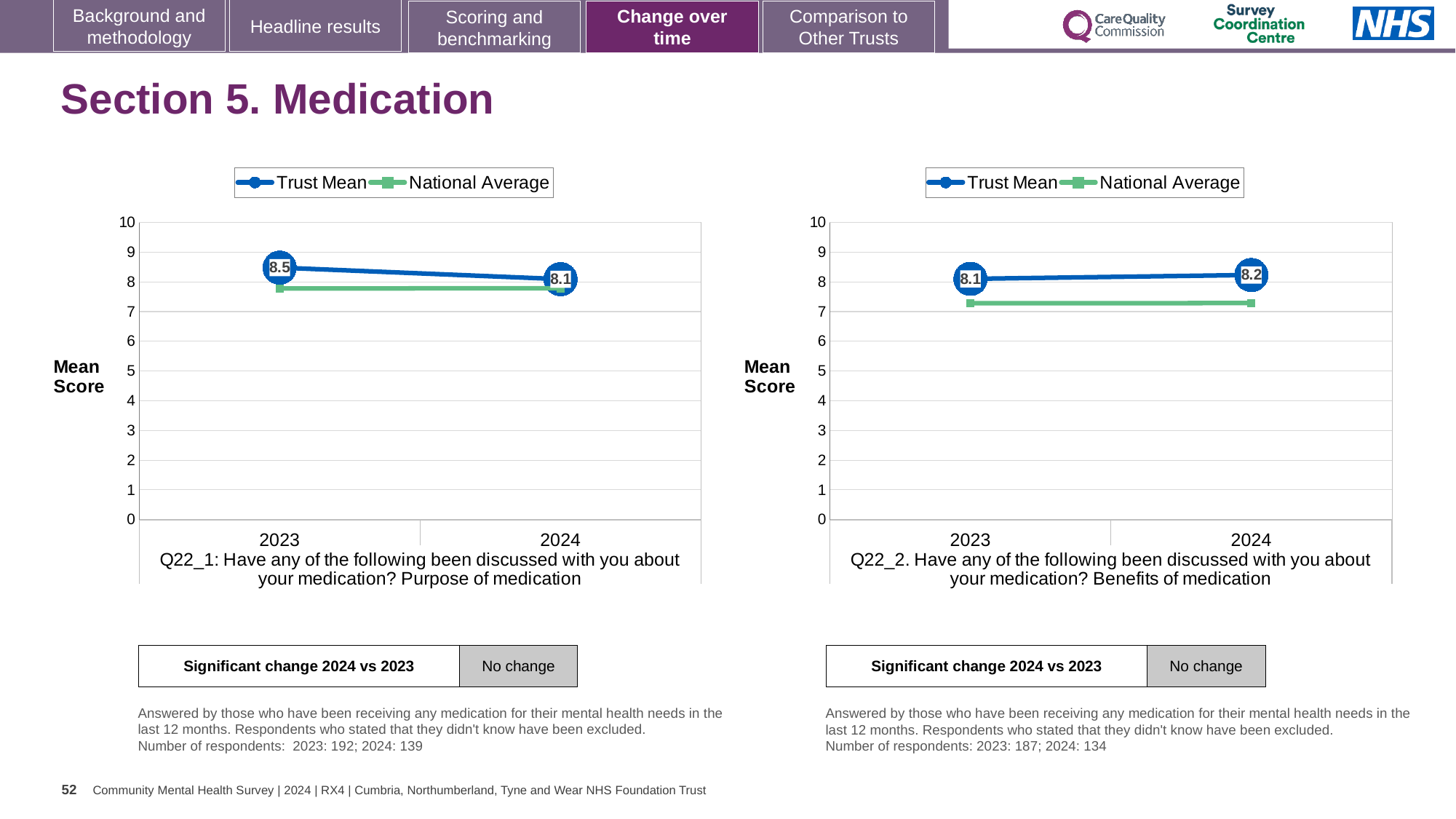
In the Q22_2 chart (Benefits of medication), does the Trust Mean rise or fall from 2023 to 2024? rise In the Q22_2 chart (Benefits of medication), what is the Trust Mean for 2024? 8.2 In the Q22_1 chart (Purpose of medication), is the National Average for 2023 greater or less than 7? greater What kind of chart is the Q22_2 chart (Benefits of medication)? line chart In the Q22_1 chart (Purpose of medication), what is the Trust Mean for 2024? 8.1 In the Q22_1 chart (Purpose of medication), does the Trust Mean rise or fall from 2023 to 2024? fall In the Q22_1 chart (Purpose of medication), what is the Trust Mean for 2023? 8.5 In the Q22_2 chart (Benefits of medication), which is larger in 2023, the Trust Mean or the National Average? Trust Mean How many series does the legend of the Q22_1 chart (Purpose of medication) list? 2 In the Q22_1 chart (Purpose of medication), by how much did the Trust Mean change from 2023 to 2024? 0.4 In the Q22_2 chart (Benefits of medication), is the National Average for 2024 greater or less than 8? less In the Q22_2 chart (Benefits of medication), what is the Trust Mean for 2023? 8.1